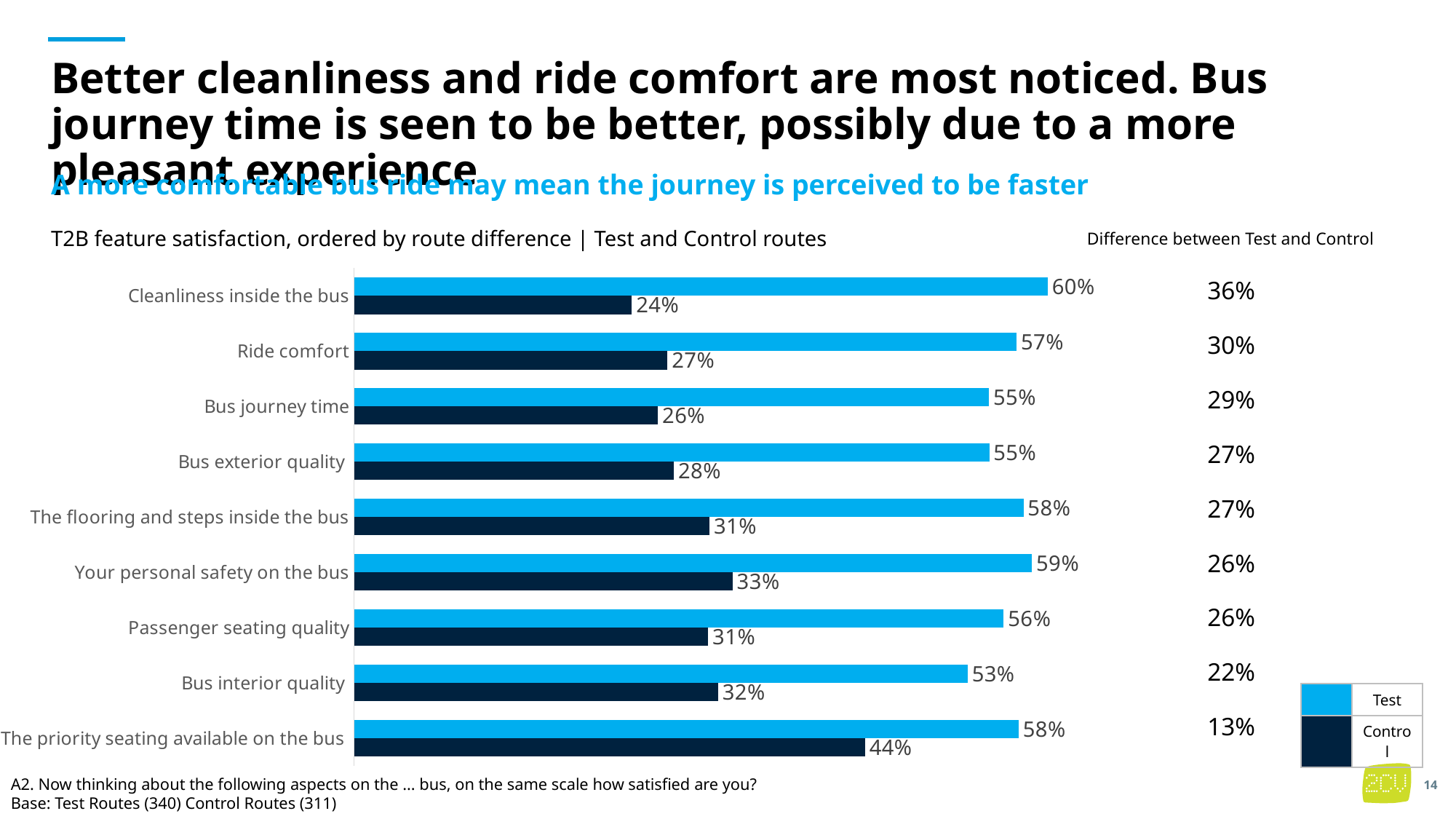
How many series does the legend list? 2 What is the difference between the Test and Control values for Bus journey time? 29% Which is larger, the Control value for Bus interior quality or the Control value for Bus exterior quality? Bus interior quality What is the Test value for Cleanliness inside the bus? 60% What is the Control value for The priority seating available on the bus? 44% Which colour represents the Control series in the chart? Dark navy What is the Control value for Ride comfort? 27% Which category has the highest Test value? Cleanliness inside the bus Which category has the lowest Test value? Bus interior quality How many categories are shown in the chart? 9 What kind of chart is shown on the slide? Bar chart Which category has the lowest Control value? Cleanliness inside the bus